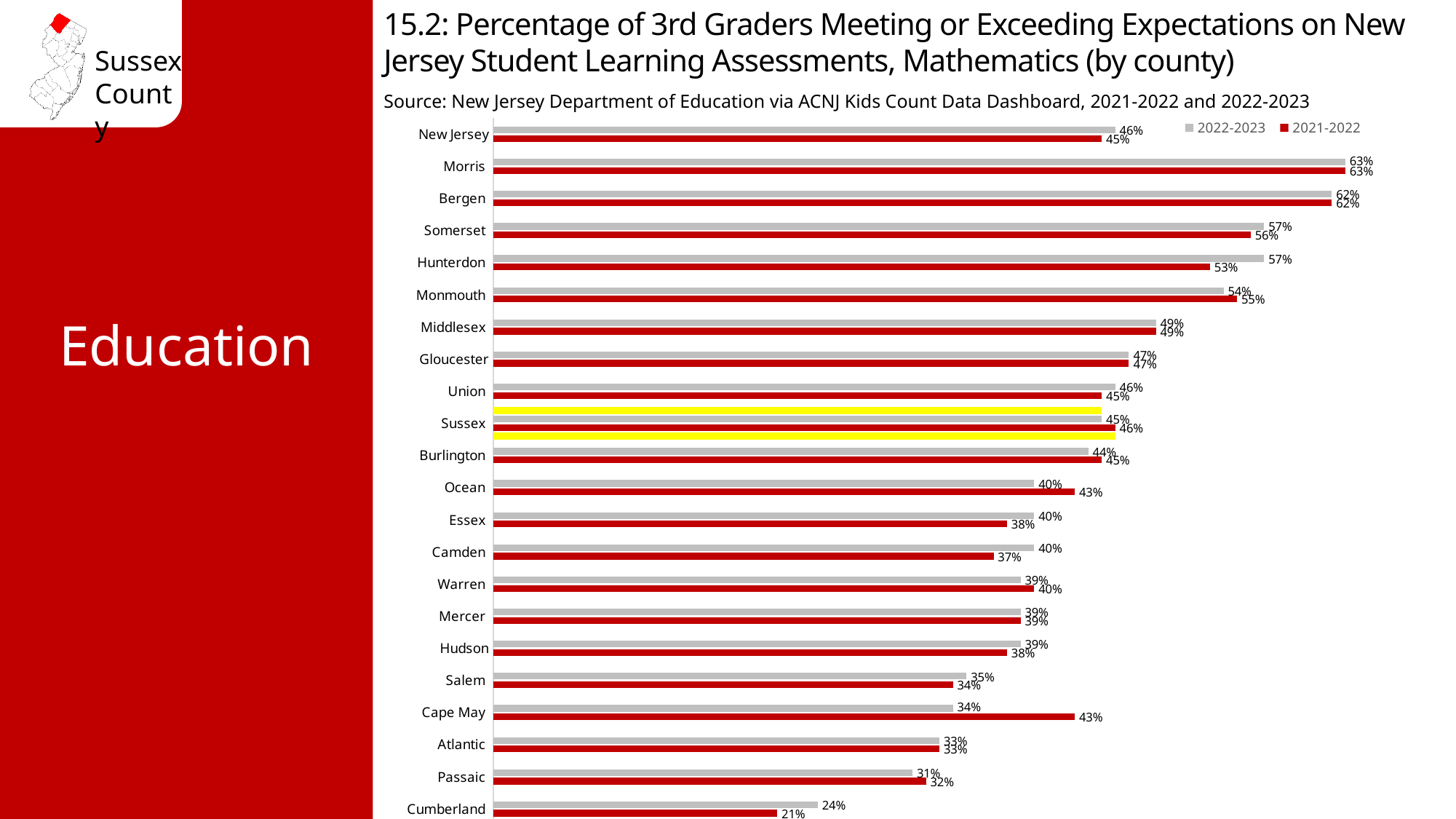
What type of chart is shown on the slide? bar chart Which is larger for Hunterdon: the 2022-2023 value or the 2021-2022 value? 2022-2023 What is the 2021-2022 value for Cape May? 43% What is the 2022-2023 value for Sussex? 45% What is the difference between the 2022-2023 and 2021-2022 values for Cape May? 9% Which county has the lowest 2021-2022 value? Cumberland What is the 2022-2023 value for Hunterdon? 57% Which county has the highest 2022-2023 value? Morris How many series does the legend list? 2 How many categories (counties plus New Jersey) are shown on the chart? 22 What is the difference between the 2022-2023 values for Morris and Cumberland? 39% Which series is shown in red in the legend? 2021-2022